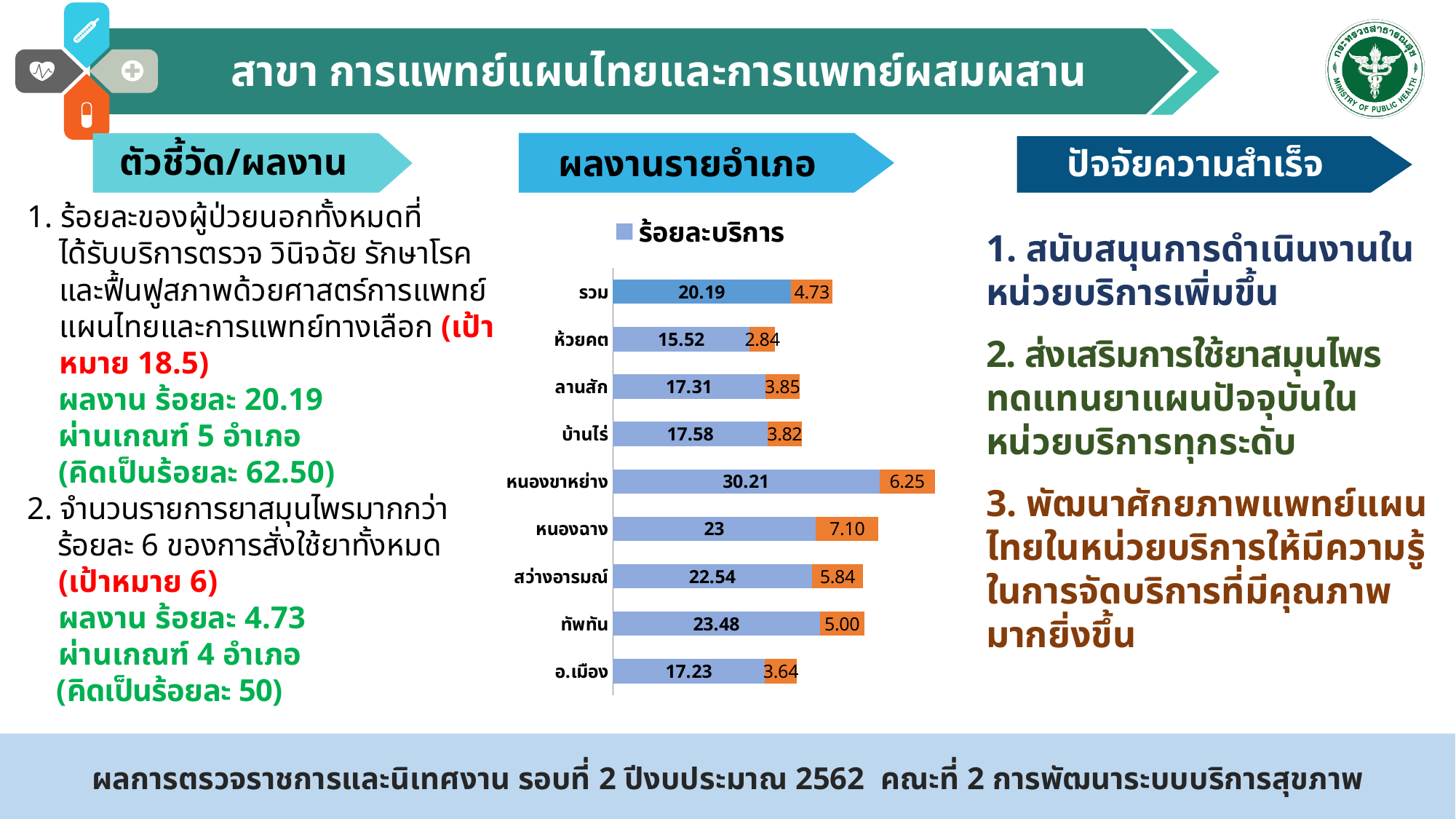
Which has a larger ร้อยละบริการ value, ทัพทัน or สว่างอารมณ์? ทัพทัน What is the total of the stacked bar for รวม? 24.92 What is the ร้อยละบริการ value for รวม? 20.19 What is the ร้อยละบริการ value for หนองขาหย่าง? 30.21 What type of chart is shown on the slide? Bar chart Which category has the lowest ร้อยละบริการ value? ห้วยคต What is the value of the orange segment for อ.เมือง? 3.64 How many categories are shown in the chart? 9 What is the difference between the ร้อยละบริการ values of หนองขาหย่าง and ห้วยคต? 14.69 What is the value of the orange segment for หนองฉาง? 7.10 Which category has the highest ร้อยละบริการ value? หนองขาหย่าง Which category has the largest orange segment value? หนองฉาง